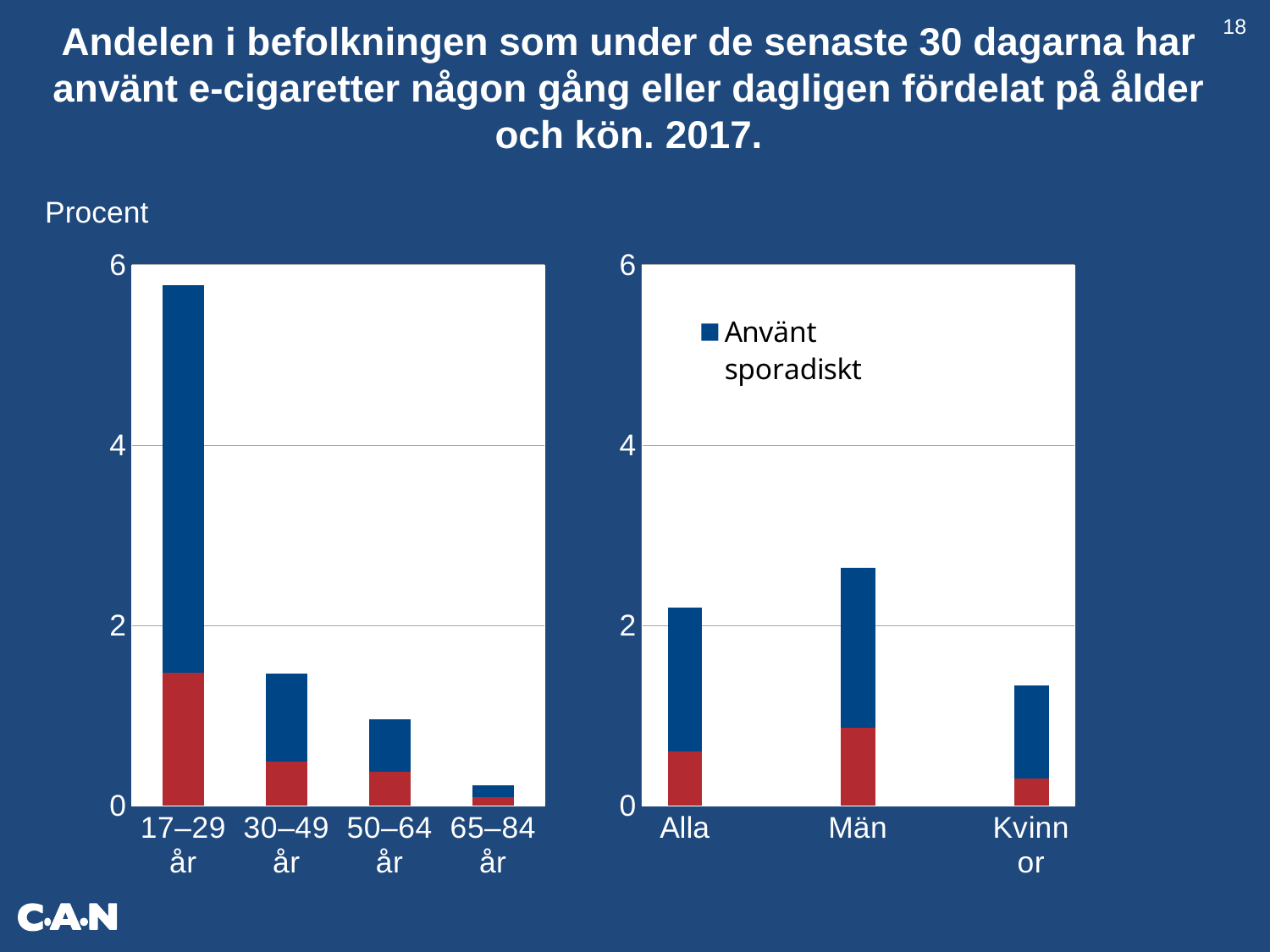
How many age groups are shown on the left chart? 4 What legend entry is shown on the right chart? Använt sporadiskt On the right chart, which has the larger total bar, Män or Kvinnor? Män How many categories are shown on the right chart? 3 On the right chart, which category has the highest total bar? Män What kind of chart is the left chart on the slide? bar chart On the right chart, is the total value for Kvinnor greater or less than 2? less On the left chart, is the total value for 17–29 år greater or less than 4? greater On the left chart, which age group has the highest total bar? 17–29 år On the left chart, is the total value for 30–49 år greater or less than 2? less On the left chart, which age group has the lowest total bar? 65–84 år On the right chart, which category has the lowest total bar? Kvinnor